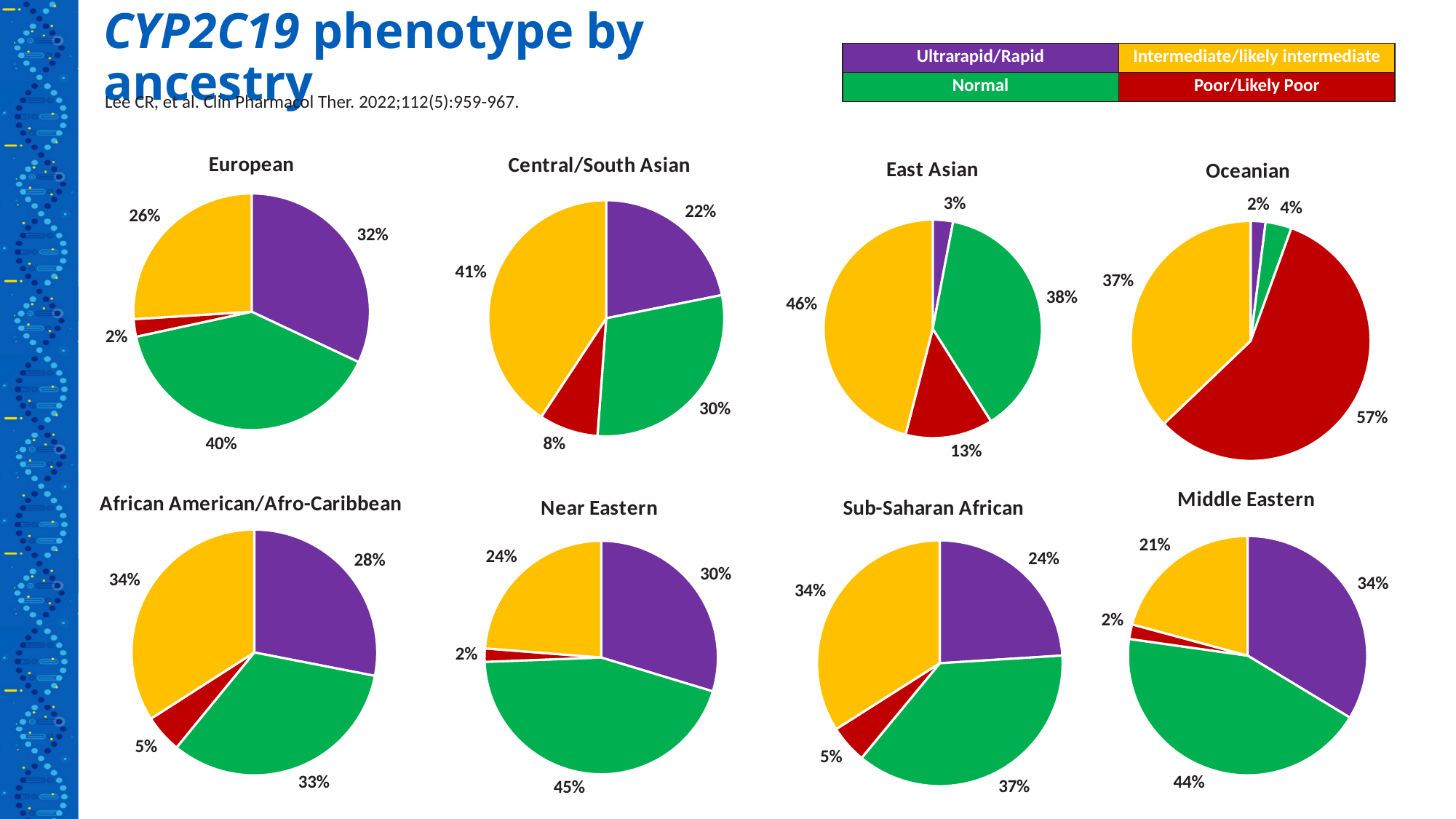
In the Near Eastern pie chart, what is the difference between the Normal share and the Ultrarapid/Rapid share? 15% What type of chart is used for the African American/Afro-Caribbean ancestry group? Pie chart In the Middle Eastern pie chart, which phenotype has the smallest share? Poor/Likely Poor In the Oceanian pie chart, what percentage is Poor/Likely Poor? 57% In the East Asian pie chart, what percentage is Ultrarapid/Rapid? 3% In the Central/South Asian pie chart, which phenotype has the largest share? Intermediate/likely intermediate Which colour represents Poor/Likely Poor in the legend? Red How many phenotype categories does the legend list? 4 In the Sub-Saharan African pie chart, which is larger: Normal or Intermediate/likely intermediate? Normal In the African American/Afro-Caribbean pie chart, what is the combined share of Ultrarapid/Rapid and Normal? 61% How many pie charts are shown on the slide? 8 In the European pie chart, what percentage is Normal? 40%